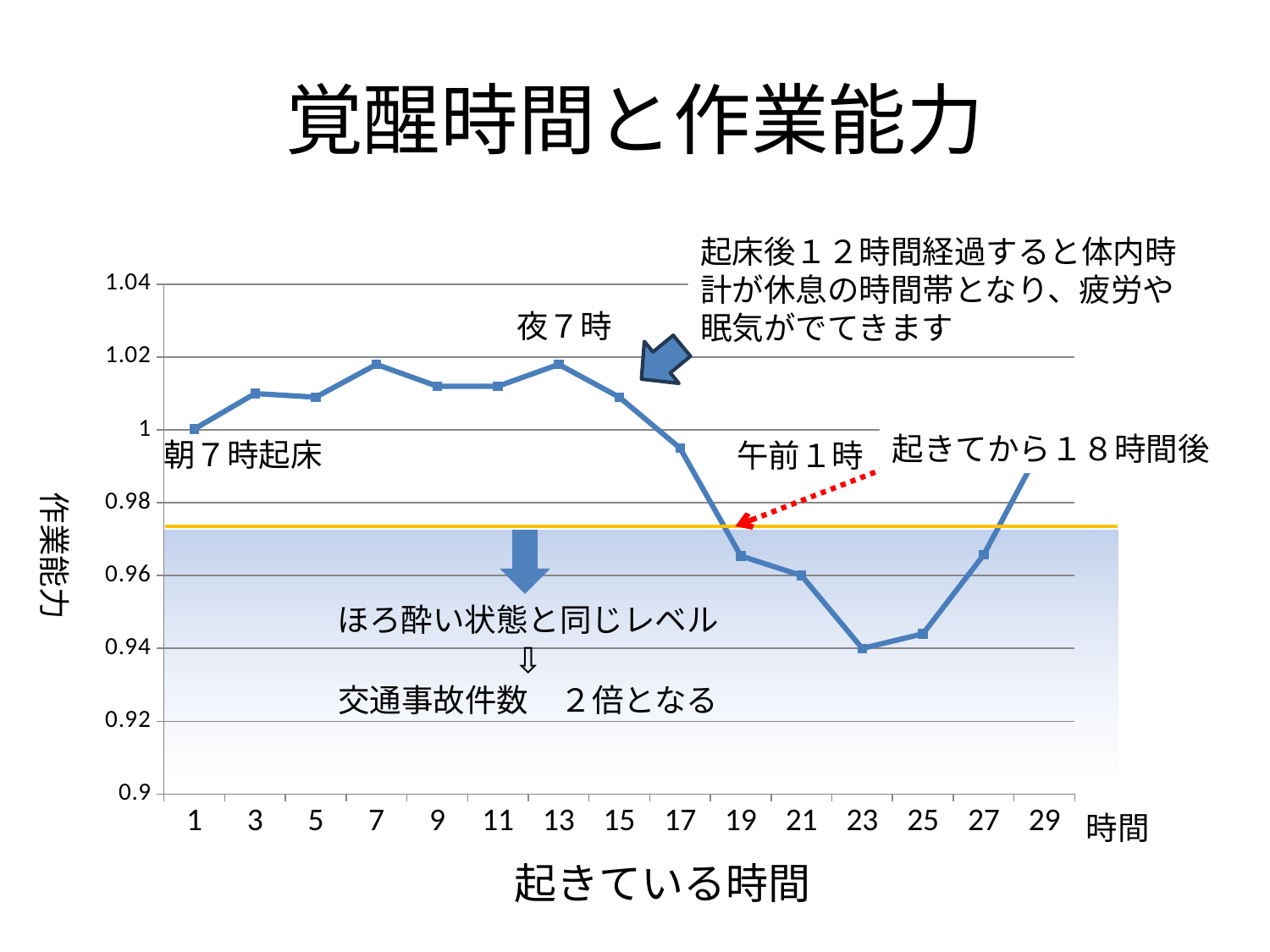
Is the value at hour 7 greater or less than 1? greater What is the value of 作業能力 at hour 23? 0.94 What is the label of the x axis? 起きている時間 How many data points are plotted on the line? 15 At which hour is 作業能力 lowest? 23 What is the difference between the value at hour 1 and the value at hour 23? 0.06 What is the value of 作業能力 at hour 1? 1 What is the value of 作業能力 at hour 21? 0.96 What is the title of the slide/chart? 覚醒時間と作業能力 What kind of chart is shown on the slide? line chart Which is larger, the value at hour 1 or the value at hour 23? hour 1 Is the value at hour 19 greater or less than 0.98? less